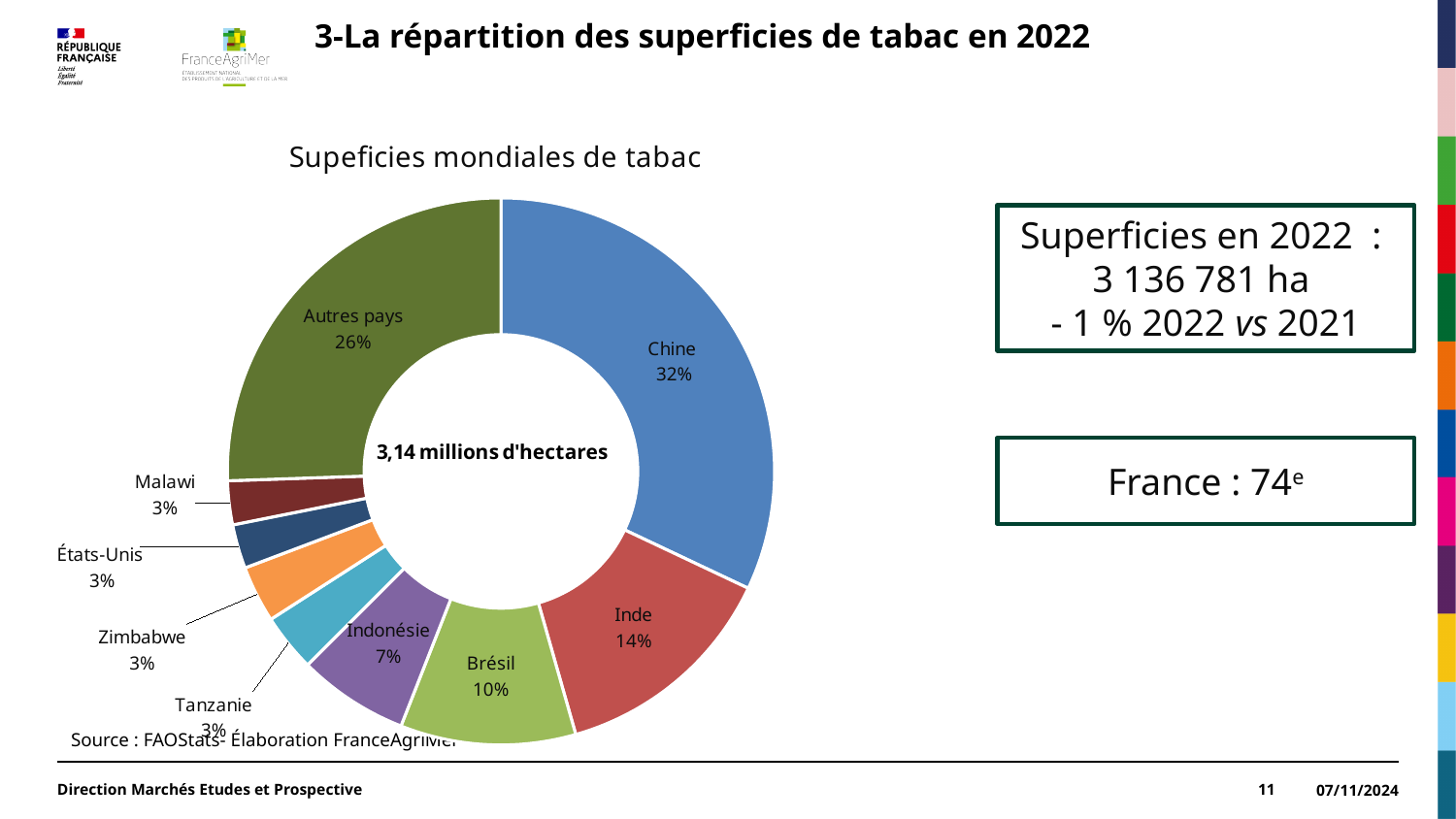
What is the title of the chart? Supeficies mondiales de tabac What percentage is shown for Brésil? 10% Which is larger, the share of Chine or the share of Autres pays? Chine What share of the pie is Inde? 14% What total area is written in the centre of the donut chart? 3,14 millions d'hectares What is the difference between the shares of Chine and Inde? 18% What share of world tobacco area does Chine hold? 32% What percentage is shown for Indonésie? 7% How many slices does the pie chart have? 9 What share is attributed to Autres pays? 26% Which country has the largest slice of the pie? Chine What kind of chart is shown on the slide? Pie chart (donut)